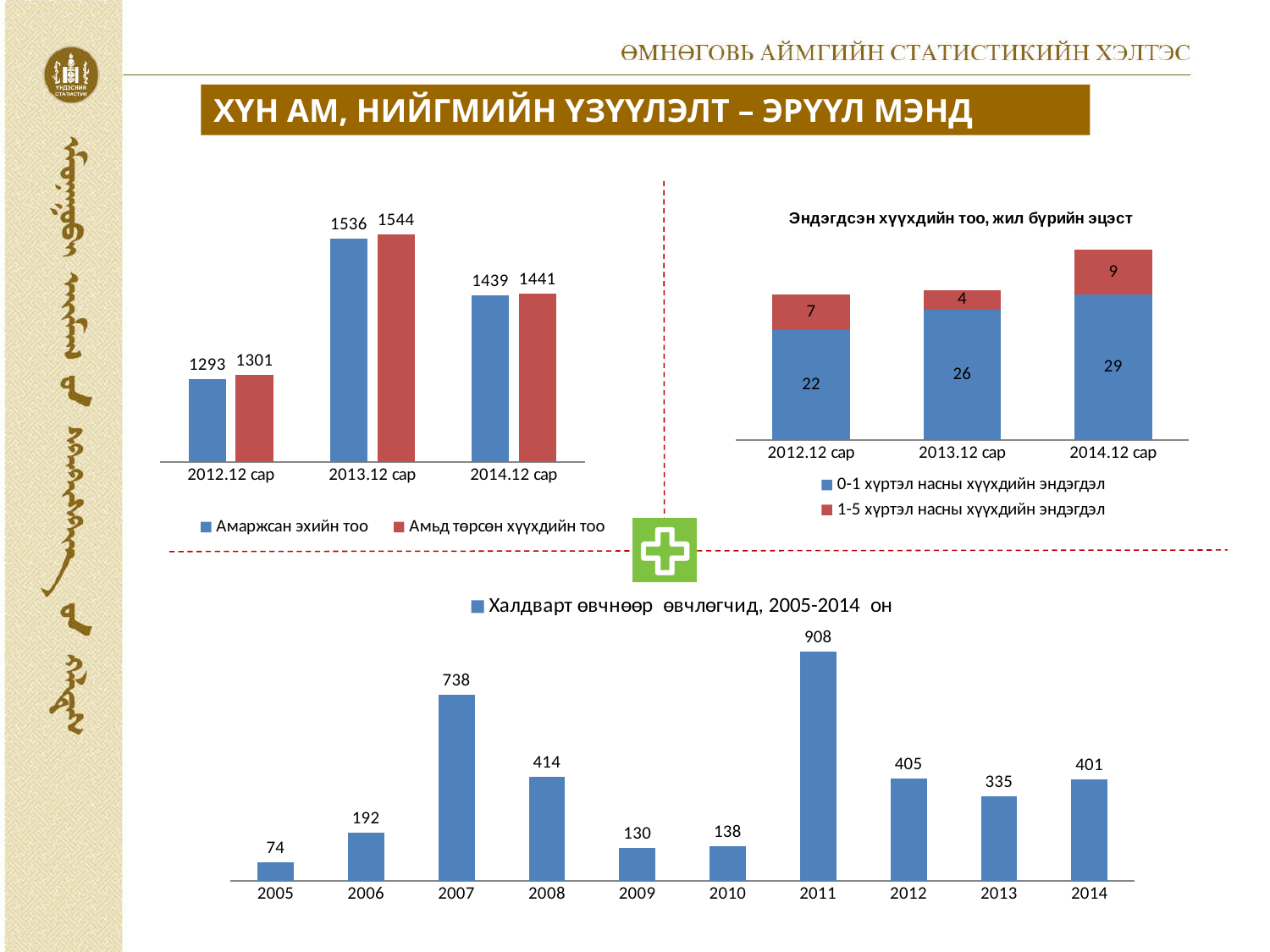
In the chart titled 'Халдварт өвчнөөр өвчлөгчид, 2005-2014 он', which is larger, the value for 2012 or the value for 2014? 2012 In the chart titled 'Халдварт өвчнөөр өвчлөгчид, 2005-2014 он', what is the value for 2008? 414 In the chart titled 'Эндэгдсэн хүүхдийн тоо, жил бүрийн эцэст', what is the total of the stacked bar for 2014.12 сар? 38 In the top-left chart, what is the value of Амьд төрсөн хүүхдийн тоо for 2012.12 сар? 1301 In the chart titled 'Халдварт өвчнөөр өвчлөгчид, 2005-2014 он', which year has the lowest value? 2005 In the top-left chart, how many series does the legend list? 2 In the chart titled 'Эндэгдсэн хүүхдийн тоо, жил бүрийн эцэст', which period has the lowest value for 1-5 хүртэл насны хүүхдийн эндэгдэл? 2013.12 сар In the chart titled 'Халдварт өвчнөөр өвчлөгчид, 2005-2014 он', how many years are shown on the x axis? 10 In the top-left chart, what is the difference between Амьд төрсөн хүүхдийн тоо and Амаржсан эхийн тоо for 2014.12 сар? 2 In the chart titled 'Халдварт өвчнөөр өвчлөгчид, 2005-2014 он', which year has the highest value? 2011 In the top-left chart, what is the value of Амаржсан эхийн тоо for 2013.12 сар? 1536 In the chart titled 'Эндэгдсэн хүүхдийн тоо, жил бүрийн эцэст', what is the value of 0-1 хүртэл насны хүүхдийн эндэгдэл for 2013.12 сар? 26